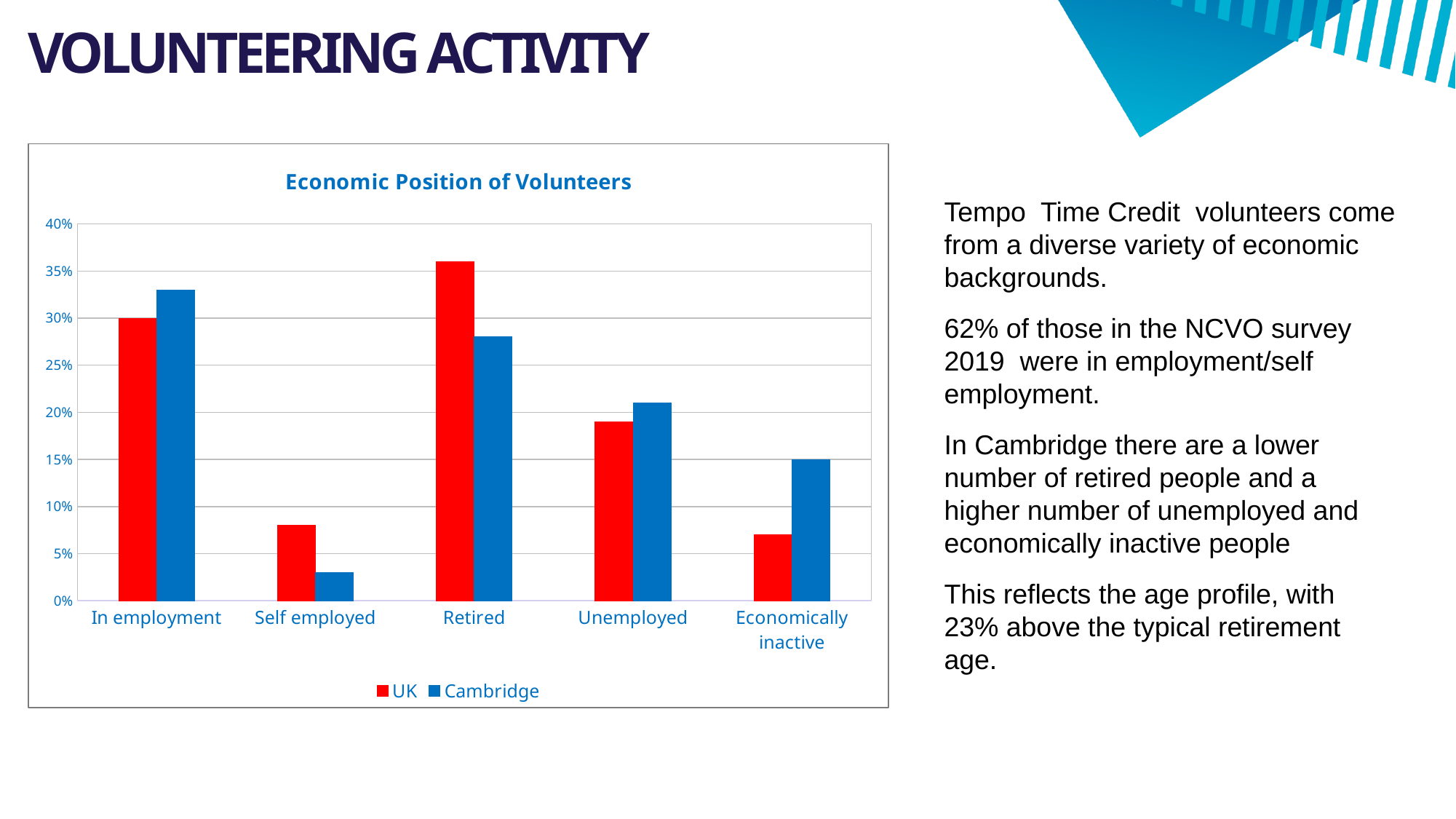
What kind of chart is shown on the slide? bar chart Which category has the lowest Cambridge value? Self employed For Economically inactive, which is larger, the UK value or the Cambridge value? Cambridge How many economic position categories are shown on the x axis? 5 Is the Cambridge value for Self employed greater or less than 5%? less How many series does the chart legend list? 2 Is the UK value for Retired greater or less than 35%? greater What is the title of the chart? Economic Position of Volunteers What is the Cambridge value for Economically inactive? 15% For Retired, which is larger, the UK value or the Cambridge value? UK What is the UK value for In employment? 30% Which category has the highest UK value? Retired